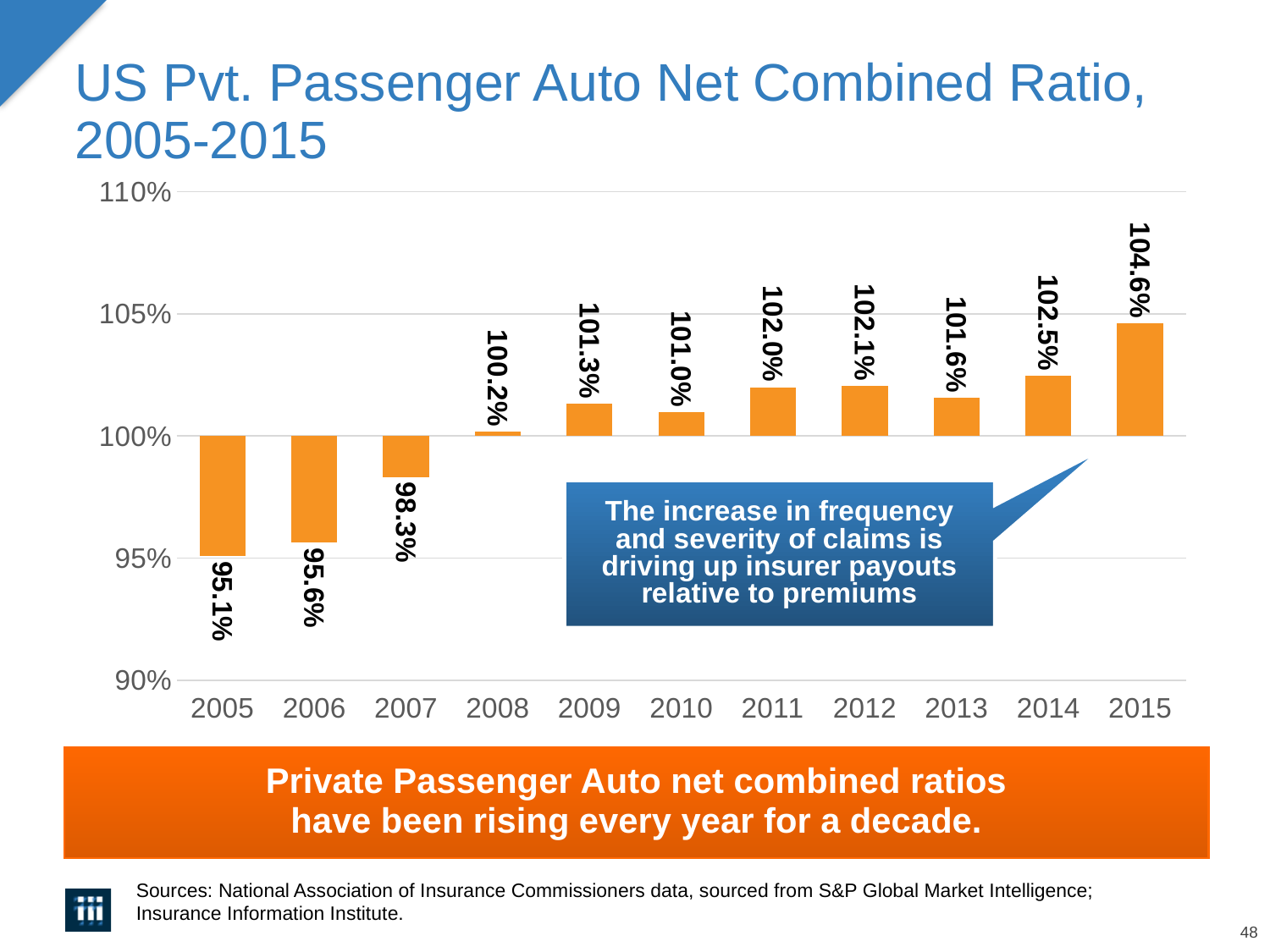
What is the net combined ratio for 2008? 100.2% What is the net combined ratio for 2015? 104.6% Which year has the highest net combined ratio? 2015 Is the value for 2007 greater or less than 100%? less Which year has the larger net combined ratio, 2009 or 2010? 2009 Do the net combined ratios generally rise or fall from 2005 to 2015? Rise What is the net combined ratio for 2005? 95.1% Which year has the lowest net combined ratio? 2005 What is the net combined ratio for 2012? 102.1% What is the difference between the 2015 and 2005 net combined ratios? 9.5% How many years are shown on the x axis? 11 What kind of chart is shown on the slide? Bar chart